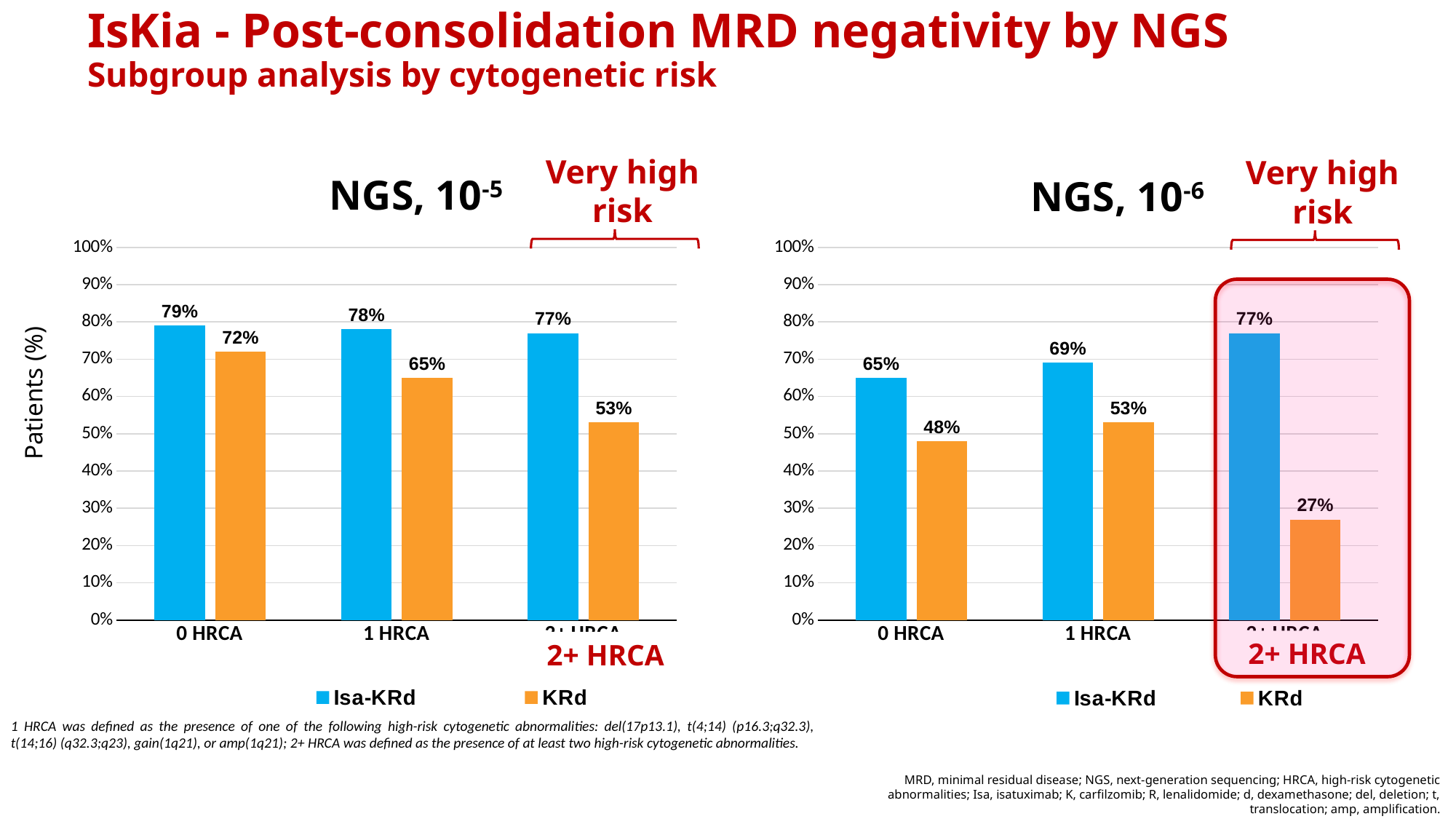
What kind of chart is the NGS, 10^-6 chart? Bar chart In the NGS, 10^-5 chart, what is the value for Isa-KRd in the 0 HRCA group? 79% In the NGS, 10^-6 chart, what is the difference between Isa-KRd and KRd in the 2+ HRCA group? 50% In the NGS, 10^-5 chart, what is the value for KRd in the 2+ HRCA group? 53% In the NGS, 10^-6 chart, what is the value for Isa-KRd in the 1 HRCA group? 69% In the NGS, 10^-6 chart, which is larger in the 0 HRCA group, Isa-KRd or KRd? Isa-KRd In the NGS, 10^-5 chart, which category has the highest Isa-KRd value? 0 HRCA How many series does the legend of the NGS, 10^-5 chart list? 2 In the NGS, 10^-5 chart, what is the difference between Isa-KRd and KRd in the 1 HRCA group? 13% In the NGS, 10^-6 chart, which category has the lowest KRd value? 2+ HRCA How many categories are shown on the x axis of the NGS, 10^-6 chart? 3 In the NGS, 10^-6 chart, what is the value for KRd in the 2+ HRCA group? 27%